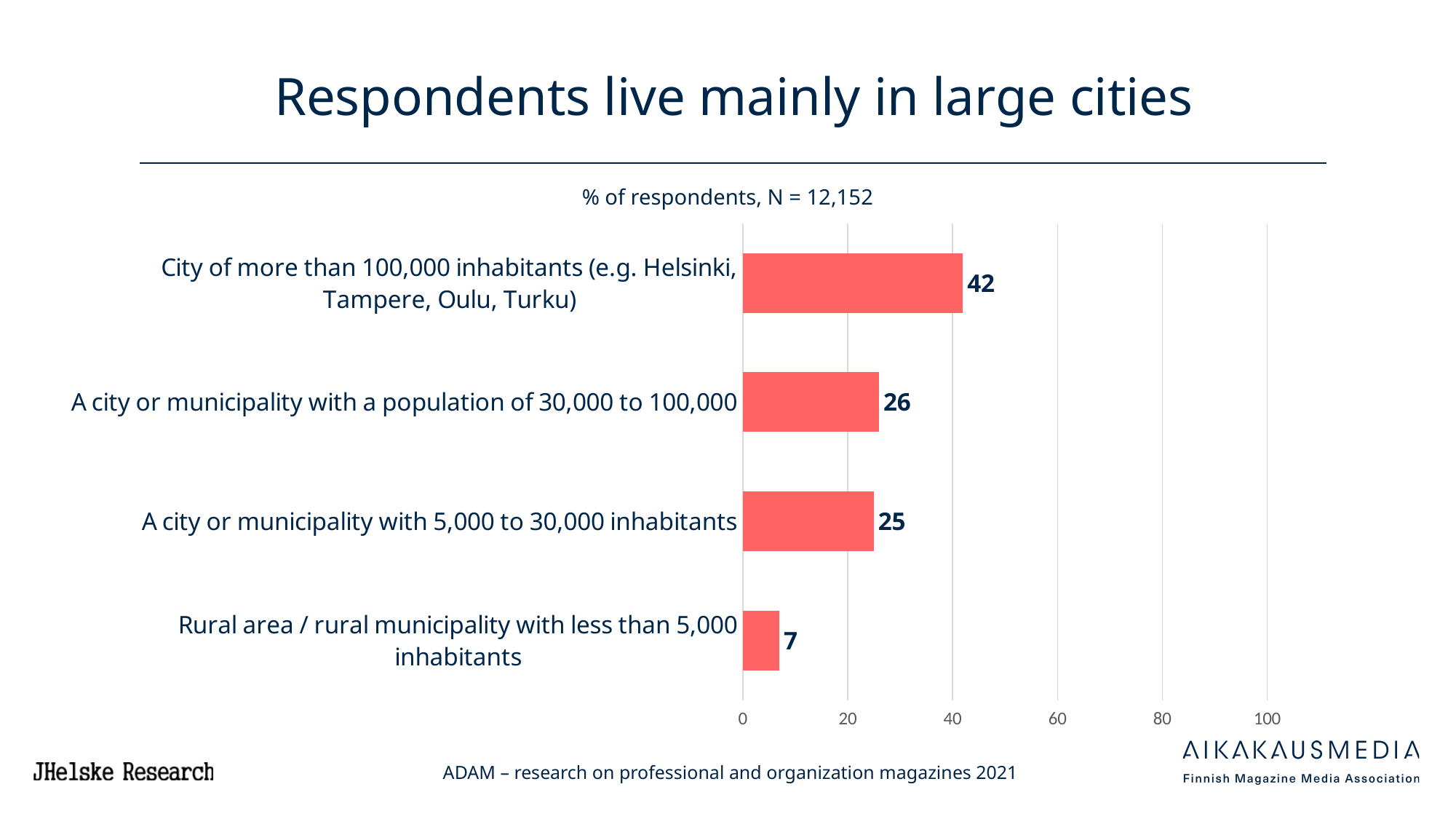
What is the difference in percentage points between respondents living in a city of more than 100,000 inhabitants and those in a city or municipality with 5,000 to 30,000 inhabitants? 17 What is the sample size (N) stated above the chart? 12,152 Which category has the lowest share of respondents? Rural area / rural municipality with less than 5,000 inhabitants Is the value for the city of more than 100,000 inhabitants greater or less than 40? greater What is the title of the slide? Respondents live mainly in large cities How many categories are shown in the chart? 4 Which is larger: the share of respondents in a city or municipality with a population of 30,000 to 100,000, or the share in a rural area with less than 5,000 inhabitants? A city or municipality with a population of 30,000 to 100,000 What percentage of respondents live in a city of more than 100,000 inhabitants? 42 What kind of chart is shown on the slide? Bar chart What percentage of respondents live in a rural area / rural municipality with less than 5,000 inhabitants? 7 Which category has the highest share of respondents? City of more than 100,000 inhabitants (e.g. Helsinki, Tampere, Oulu, Turku) What percentage of respondents live in a city or municipality with a population of 30,000 to 100,000? 26